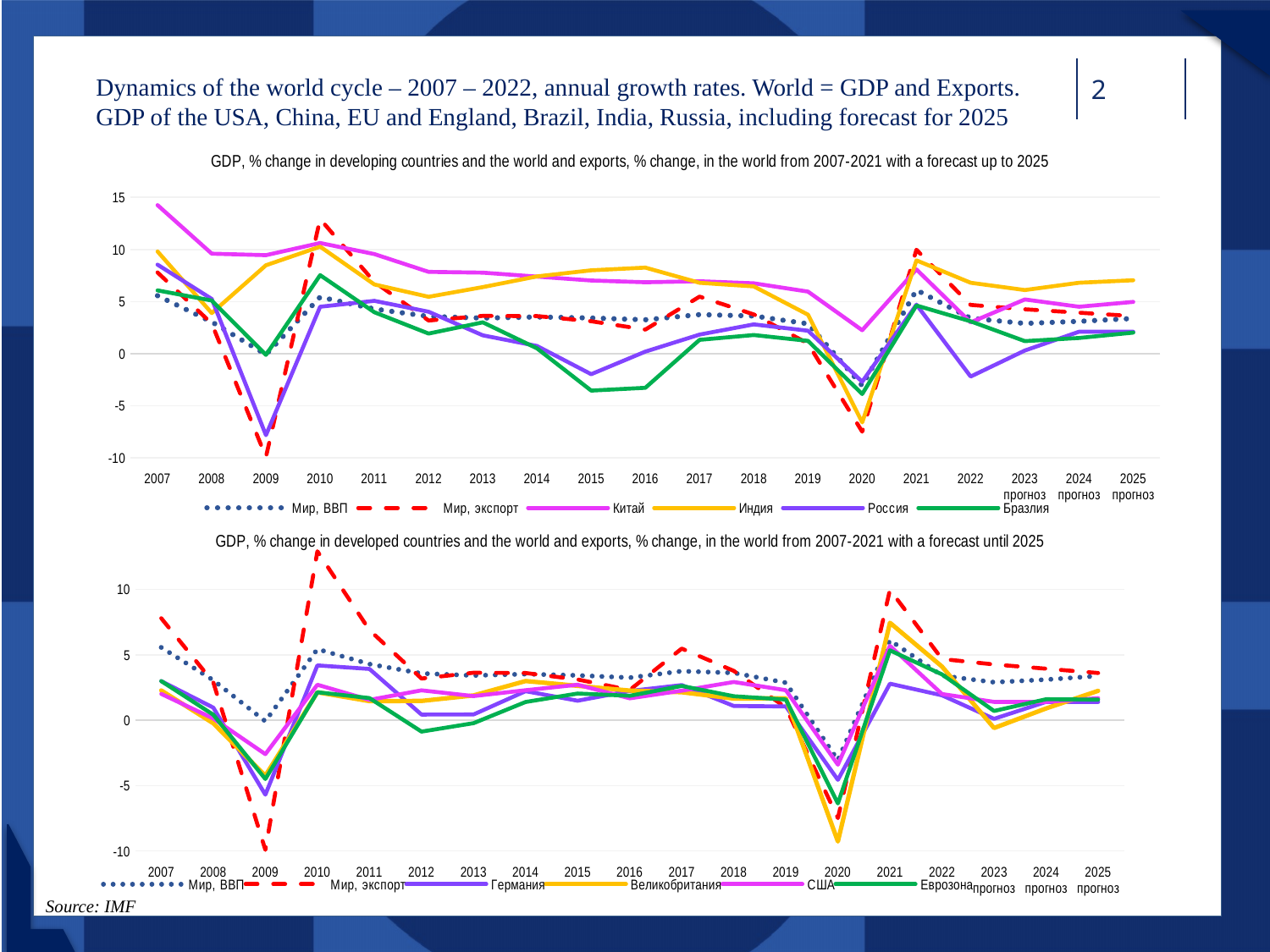
In the top chart (developing countries), which series has the lowest value in 2009? Мир, экспорт How many series does the legend of the bottom chart (developed countries) list? 6 In the top chart (developing countries), does the Китай line rise or fall from 2007 to 2012? fall In the bottom chart (developed countries), is the value for Мир, экспорт in 2010 greater or less than 10? greater In the top chart (developing countries), is the value for Россия in 2009 greater or less than -5? less How many years are shown along the x axis of the top chart? 19 In the bottom chart (developed countries), which series has the lowest value in 2009? Мир, экспорт In the top chart (developing countries), which series has the highest value in 2007? Китай What kind of chart is the top chart on the slide? line chart In the top chart (developing countries), which is larger in 2007, Китай or Индия? Китай In the top chart (developing countries), is the value for Китай in 2007 greater or less than 10? greater How many series does the legend of the top chart (developing countries) list? 6